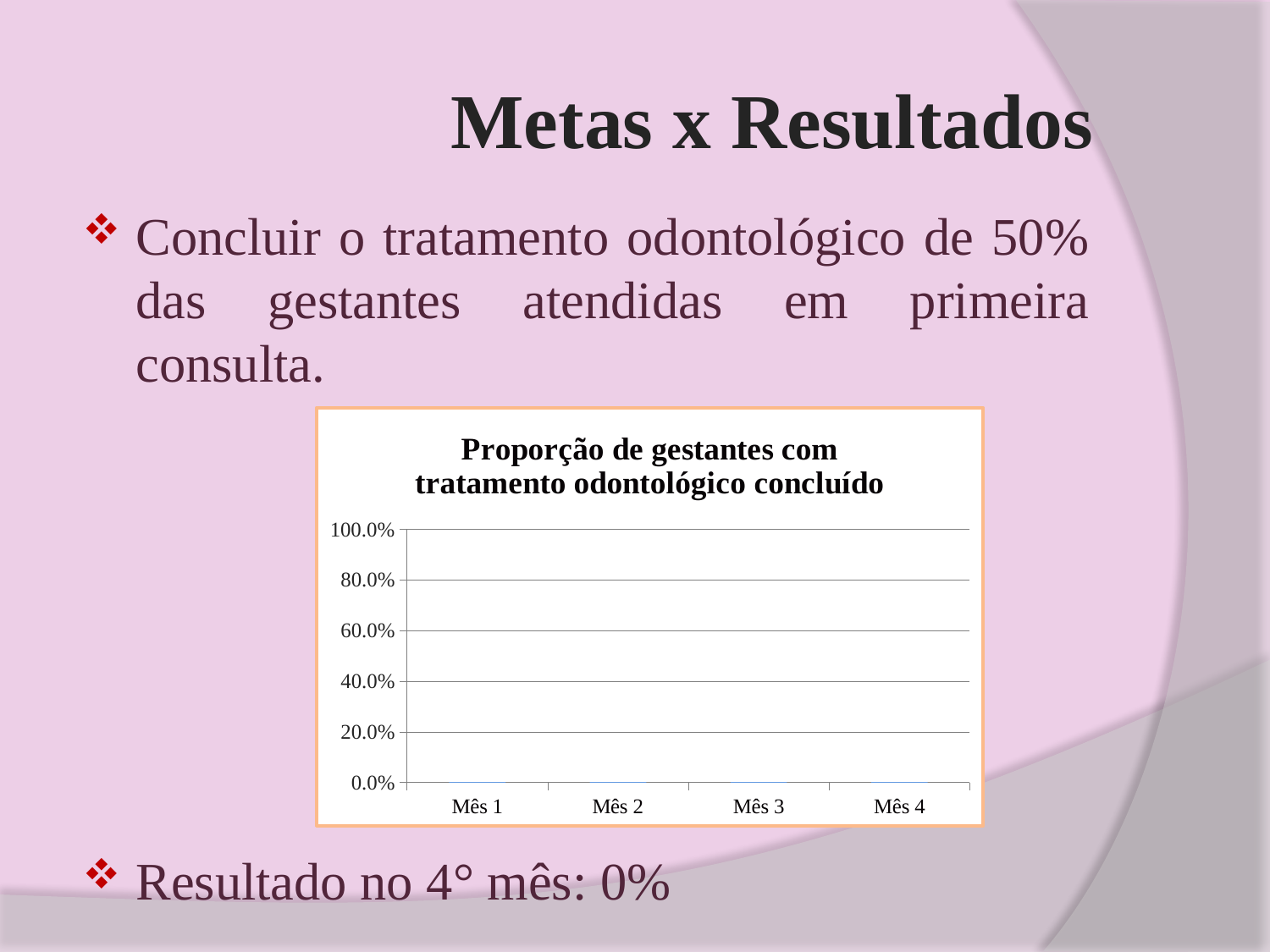
How many months (categories) are shown on the x axis of the chart? 4 Is the value for Mês 1 greater or less than 20.0%? less Is the value for Mês 2 greater or less than 40.0%? less Do the values rise, fall, or stay the same from Mês 1 to Mês 4? stay the same Is the value for Mês 4 greater or less than 20.0%? less What kind of chart is shown on the slide? bar chart What is the title of the chart on the slide? Proporção de gestantes com tratamento odontológico concluído What is the highest value shown on the chart's vertical axis? 100.0% What value does the chart show for Mês 4? 0.0% What is the label of the first category on the x axis? Mês 1